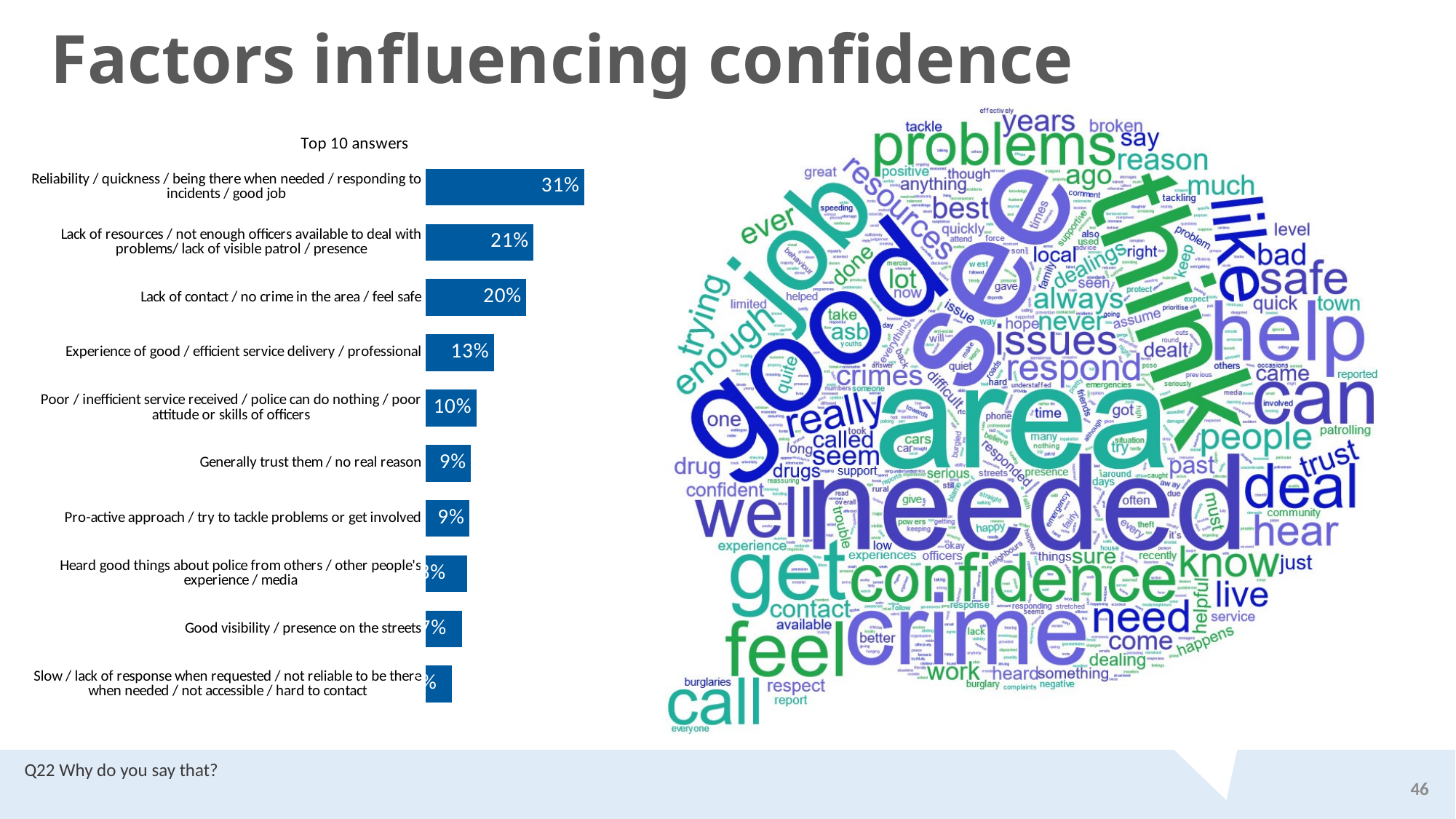
In the Top 10 answers chart, what is the value for 'Generally trust them / no real reason'? 9% In the Top 10 answers chart, what percentage is shown for 'Reliability / quickness / being there when needed / responding to incidents / good job'? 31% In the Top 10 answers chart, what percentage is shown for 'Poor / inefficient service received / police can do nothing / poor attitude or skills of officers'? 10% What type of chart is the Top 10 answers chart on the left of the slide? Bar chart In the Top 10 answers chart, what is the difference in percentage points between 'Reliability / quickness / being there when needed / responding to incidents / good job' and 'Lack of resources / not enough officers available to deal with problems/ lack of visible patrol / presence'? 10 percentage points In the Top 10 answers chart, what percentage is shown for 'Lack of resources / not enough officers available to deal with problems/ lack of visible patrol / presence'? 21% In the Top 10 answers chart, what is the value for 'Experience of good / efficient service delivery / professional'? 13% In the Top 10 answers chart, which is larger: 'Lack of resources / not enough officers available to deal with problems/ lack of visible patrol / presence' or 'Lack of contact / no crime in the area / feel safe'? Lack of resources / not enough officers available to deal with problems/ lack of visible patrol / presence In the Top 10 answers chart, what is the value for 'Lack of contact / no crime in the area / feel safe'? 20% How many answer categories are shown in the Top 10 answers chart? 10 In the Top 10 answers chart, which answer has the shortest bar? Slow / lack of response when requested / not reliable to be there when needed / not accessible / hard to contact In the Top 10 answers chart, which answer has the highest percentage? Reliability / quickness / being there when needed / responding to incidents / good job